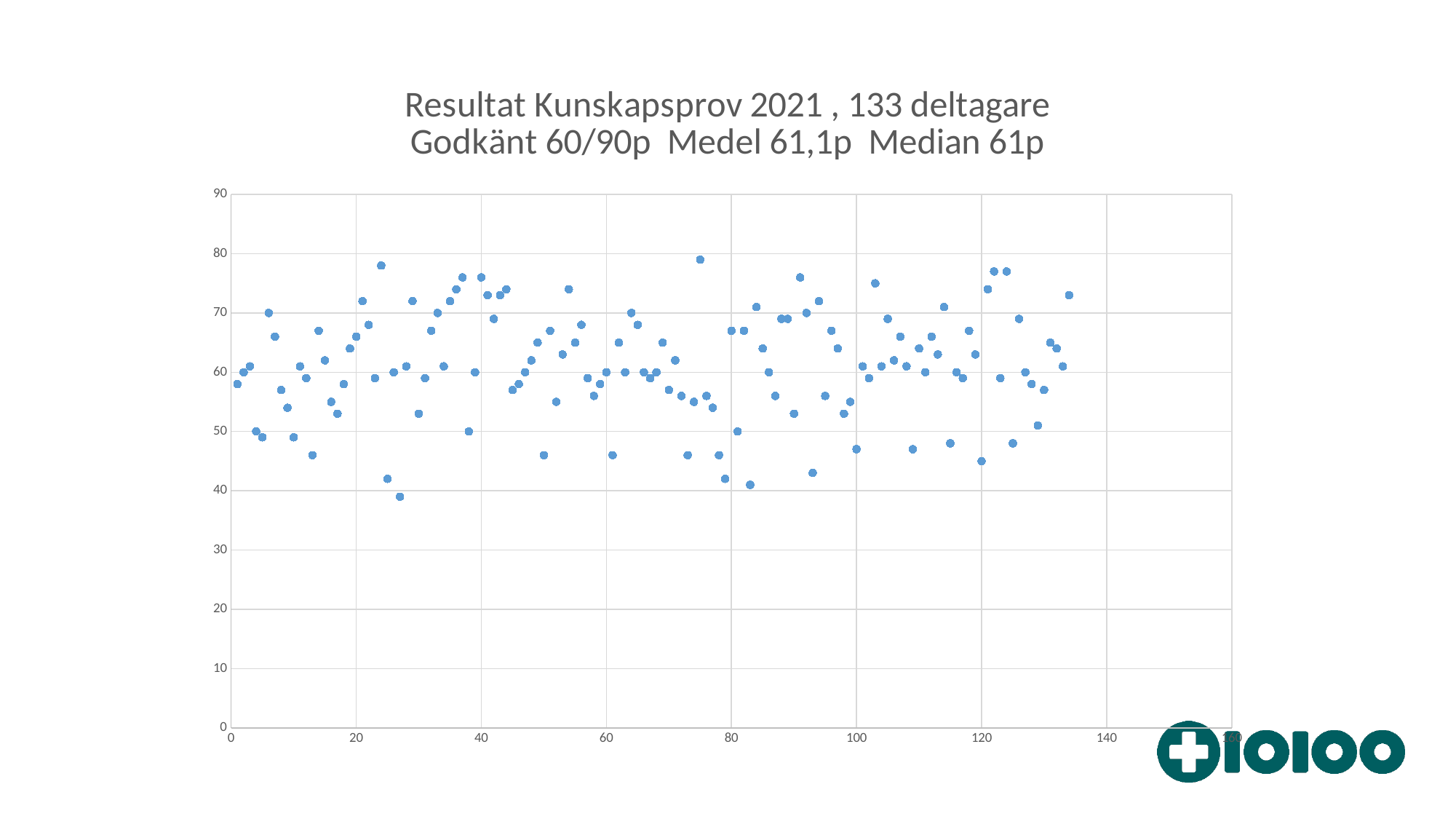
Is the lowest plotted value on the chart greater or less than 50? less Do the plotted values show a clear rising or falling trend along the x axis, or no clear trend? no clear trend What is the title of the chart? Resultat Kunskapsprov 2021 , 133 deltagare Godkänt 60/90p Medel 61,1p Median 61p According to the chart title, what is the mean (Medel) score? 61,1p Is the lowest plotted value on the chart greater or less than 30? greater Is the value for the first participant (x = 1) greater or less than 70? less What kind of chart is shown on the slide? scatter chart How many participants (deltagare) does the chart title say took the Kunskapsprov 2021? 133